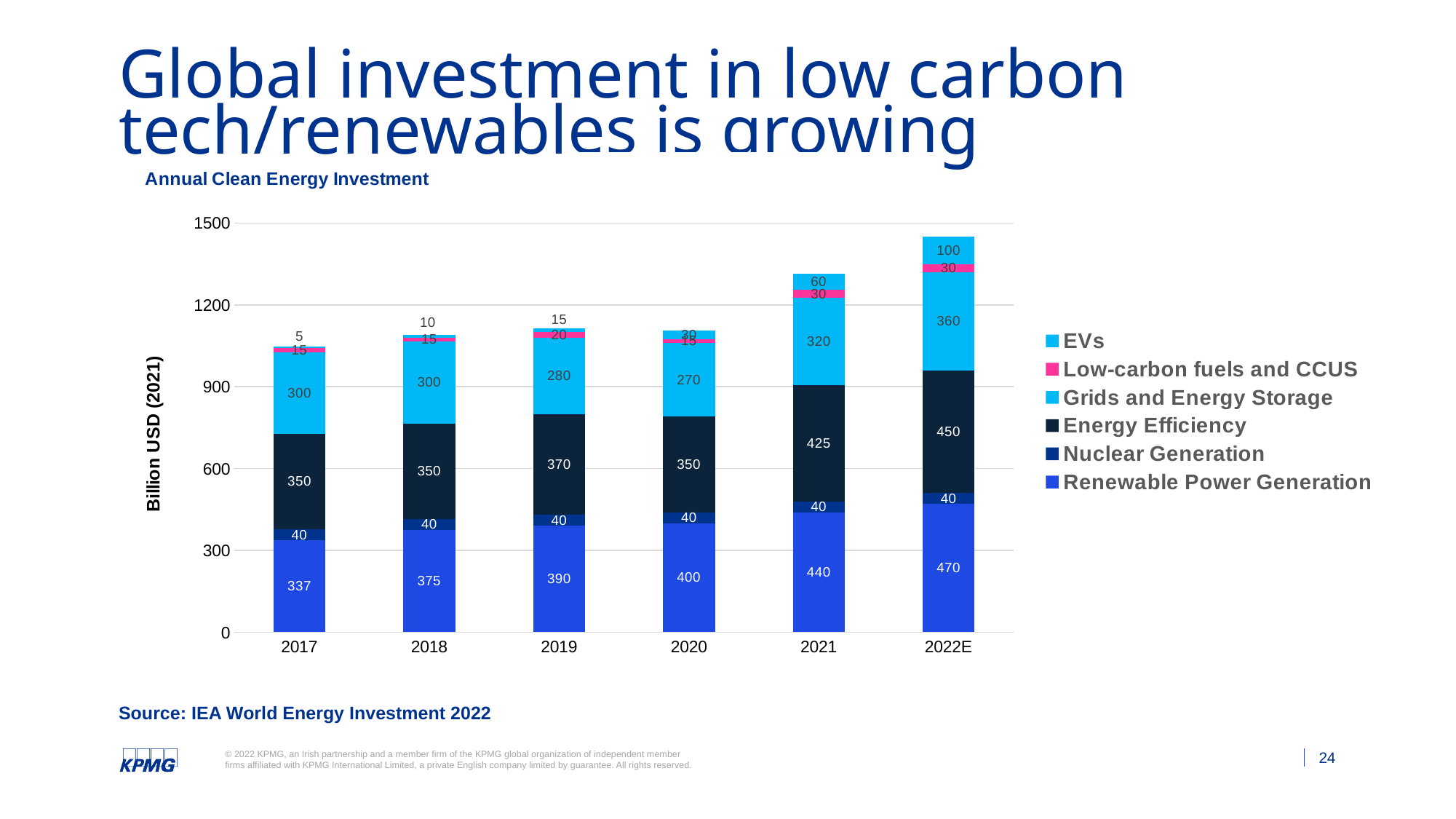
What is the difference between the Renewable Power Generation values for 2022E and 2017? 133 How many series does the legend list? 6 How many years are shown on the x axis? 6 What is the value for Grids and Energy Storage in 2019? 280 Does the Renewable Power Generation value rise or fall from 2017 to 2022E? Rise Which year has the highest value for Renewable Power Generation? 2022E In 2019, which is larger: Energy Efficiency or Grids and Energy Storage? Energy Efficiency What is the value for Renewable Power Generation in 2022E? 470 What is the value for Energy Efficiency in 2021? 425 What kind of chart is shown on the slide? Stacked bar chart What is the total of the stacked bar for 2022E? 1450 Which year has the lowest value for EVs? 2017